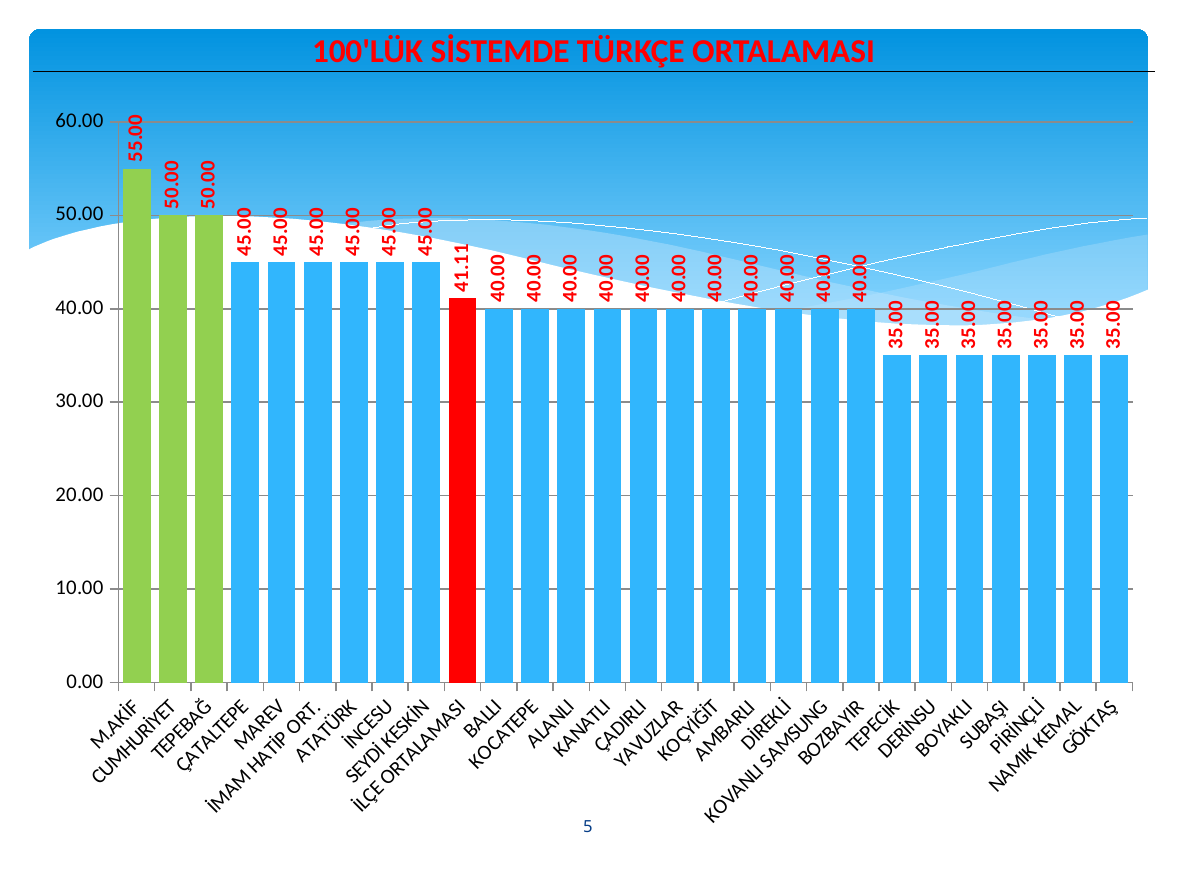
What kind of chart is this? Bar chart What is the difference between the values for M.AKİF and İLÇE ORTALAMASI? 13.89 What is the title of the chart? 100'LÜK SİSTEMDE TÜRKÇE ORTALAMASI Which is larger, the value for CUMHURİYET or the value for BALLI? CUMHURİYET Do the values rise or fall from left to right along the x axis? Fall Which category has the highest value? M.AKİF What is the value for KOCATEPE? 40.00 What is the value for İLÇE ORTALAMASI? 41.11 What is the difference between the values for ÇATALTEPE and TEPECİK? 10.00 What is the value for GÖKTAŞ? 35.00 What is the value for M.AKİF? 55.00 How many categories are shown on the x axis? 28